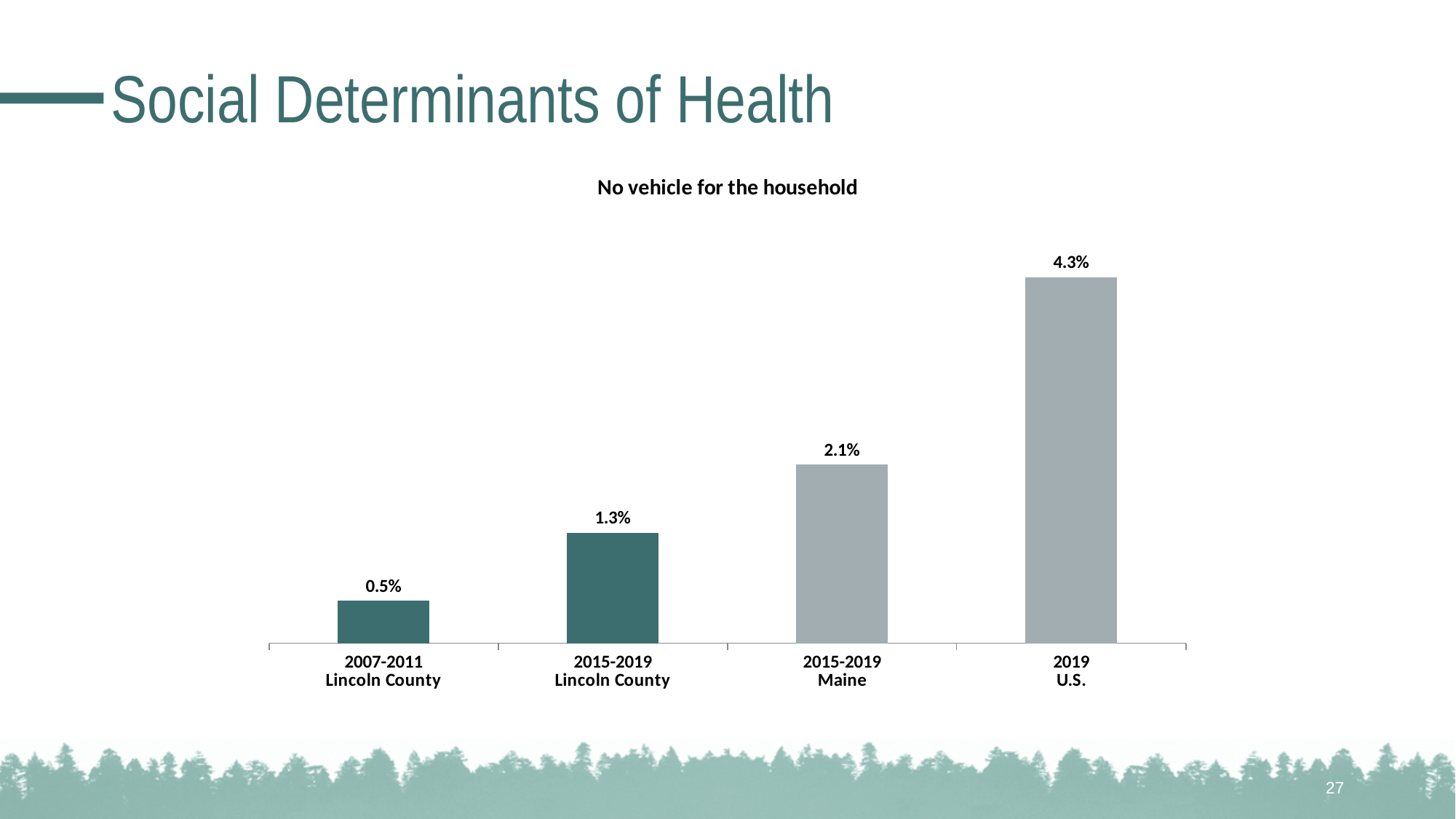
How many categories are shown on the x axis? 4 Which is larger, the value for 2015-2019 Maine or the value for 2015-2019 Lincoln County? 2015-2019 Maine What is the title of the chart? No vehicle for the household What is the value for 2015-2019 Maine? 2.1% What is the value for 2015-2019 Lincoln County? 1.3% Which category has the lowest value? 2007-2011 Lincoln County Which category has the highest value? 2019 U.S. What is the value for 2007-2011 Lincoln County? 0.5% What is the value for 2019 U.S.? 4.3% What is the difference between the 2019 U.S. value and the 2015-2019 Maine value? 2.2% What kind of chart is shown? Bar chart What is the difference between the 2015-2019 Lincoln County value and the 2007-2011 Lincoln County value? 0.8%